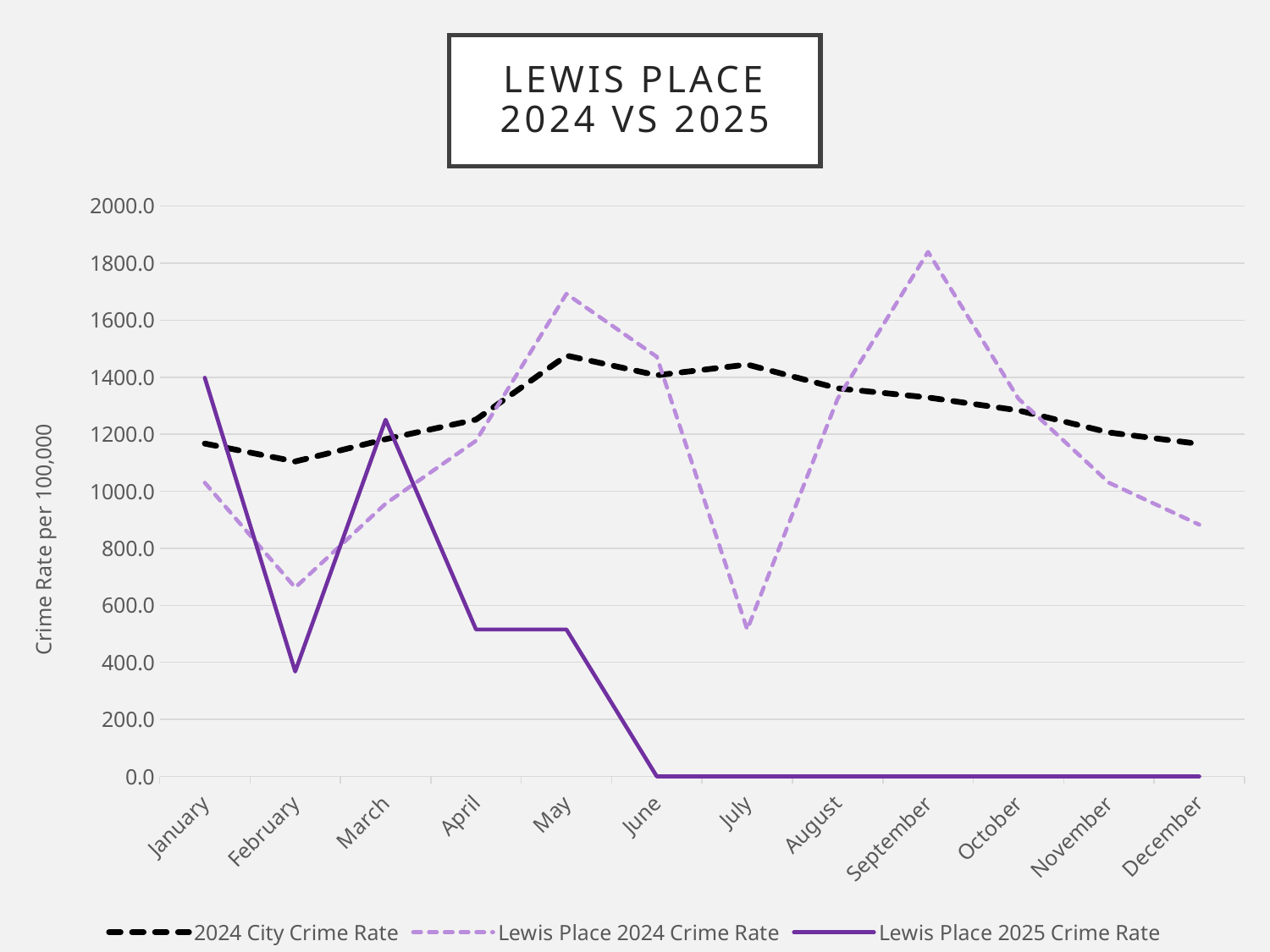
What kind of chart is shown on the slide? line chart What is the Lewis Place 2025 Crime Rate in June? 0.0 Is the Lewis Place 2025 Crime Rate in February greater or less than 600? less In which month is the Lewis Place 2024 Crime Rate lowest? July In which month is the Lewis Place 2024 Crime Rate highest? September How many months are plotted along the x axis? 12 What is the Lewis Place 2025 Crime Rate in December? 0.0 In which month is the 2024 City Crime Rate lowest? February In July, which is higher: the 2024 City Crime Rate or the Lewis Place 2024 Crime Rate? 2024 City Crime Rate How many series does the legend list? 3 Is the Lewis Place 2024 Crime Rate in September greater or less than 1600? greater Does the Lewis Place 2025 Crime Rate rise or fall from March to June? fall